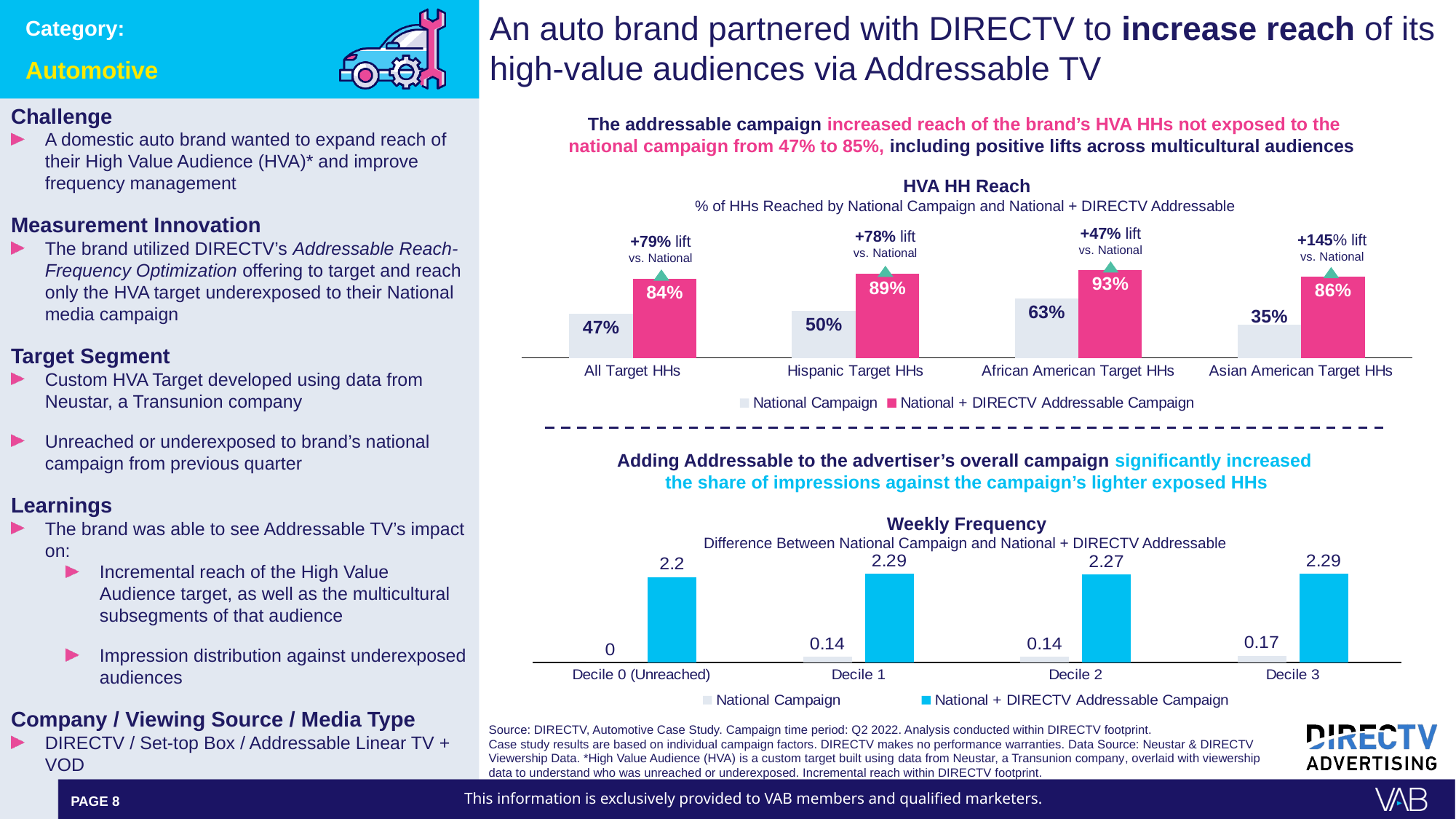
In the HVA HH Reach chart, what lift vs. National is shown for Asian American Target HHs? +145% In the Weekly Frequency chart, what is the National + DIRECTV Addressable Campaign value for Decile 0 (Unreached)? 2.2 What kind of chart is the Weekly Frequency chart? Bar chart In the HVA HH Reach chart, which category has the highest National + DIRECTV Addressable Campaign reach? African American Target HHs In the HVA HH Reach chart, what is the National Campaign reach for Hispanic Target HHs? 50% How many categories are shown on the x axis of the Weekly Frequency chart? 4 In the HVA HH Reach chart, what is the National + DIRECTV Addressable Campaign reach for African American Target HHs? 93% In the HVA HH Reach chart, what is the difference between the National + DIRECTV Addressable Campaign reach and the National Campaign reach for All Target HHs? 37% In the HVA HH Reach chart, which category has the lowest National Campaign reach? Asian American Target HHs How many series does the legend of the HVA HH Reach chart list? 2 In the Weekly Frequency chart, what is the National Campaign value for Decile 3? 0.17 In the Weekly Frequency chart, which decile has the lowest National + DIRECTV Addressable Campaign value? Decile 0 (Unreached)